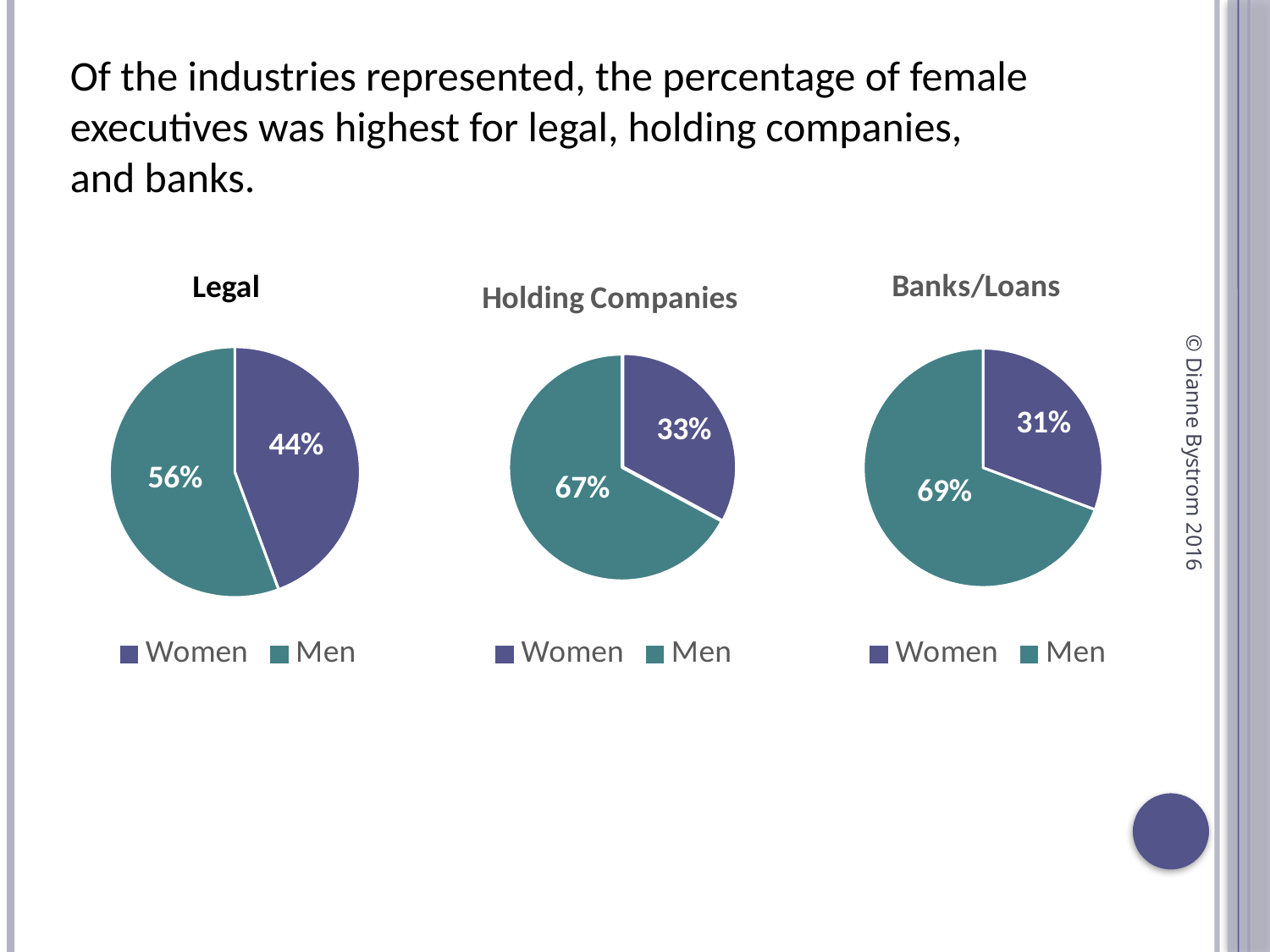
How many pie charts are shown on the slide? 3 What type of chart is the Legal chart? Pie chart In the Holding Companies chart, what is the difference between the Men and Women percentages? 34% In the Legal chart, what percentage is shown for Men? 56% In the Holding Companies chart, what percentage is shown for Men? 67% In the Holding Companies chart, what percentage is shown for Women? 33% In the Banks/Loans chart, what percentage is shown for Men? 69% In the Banks/Loans chart, what percentage is shown for Women? 31% How many entries does the legend of the Banks/Loans chart list? 2 In the Legal chart, which slice is larger, Women or Men? Men In the Legal chart, what percentage is shown for Women? 44% In the Banks/Loans chart, what is the difference between the Men and Women percentages? 38%